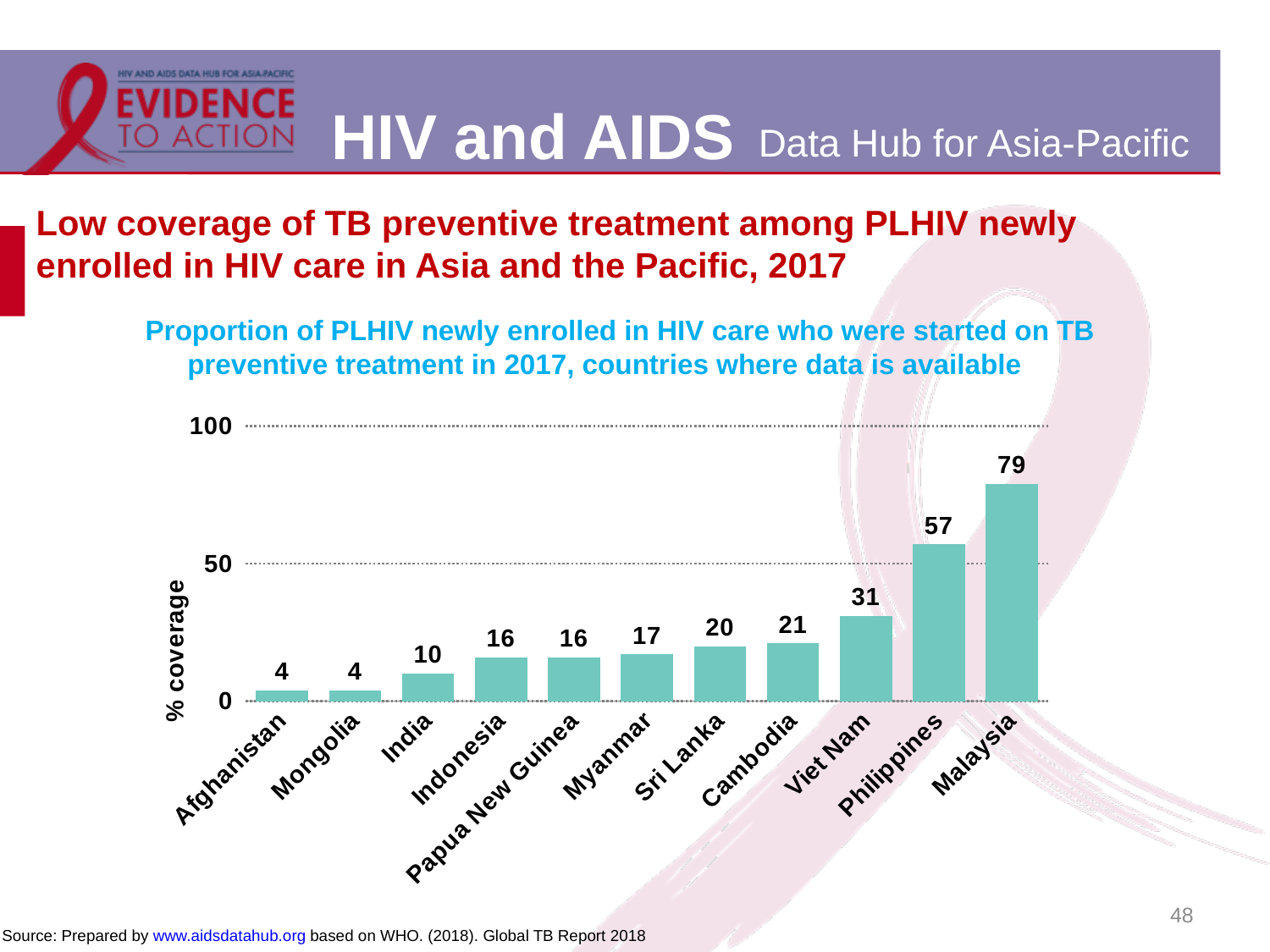
What is the % coverage value for Viet Nam? 31 What is the difference in % coverage between Malaysia and the Philippines? 22 How many countries are shown in the chart? 11 What kind of chart is shown on the slide? Bar chart Which has a higher % coverage, India or Myanmar? Myanmar What is the difference in % coverage between Viet Nam and Cambodia? 10 Is the value for the Philippines greater or less than 50? greater What is the % coverage value for Sri Lanka? 20 Which country has the highest % coverage? Malaysia Which countries share the lowest % coverage value? Afghanistan and Mongolia Do the values rise or fall from left to right along the x axis? Rise What is the % coverage value for Malaysia? 79